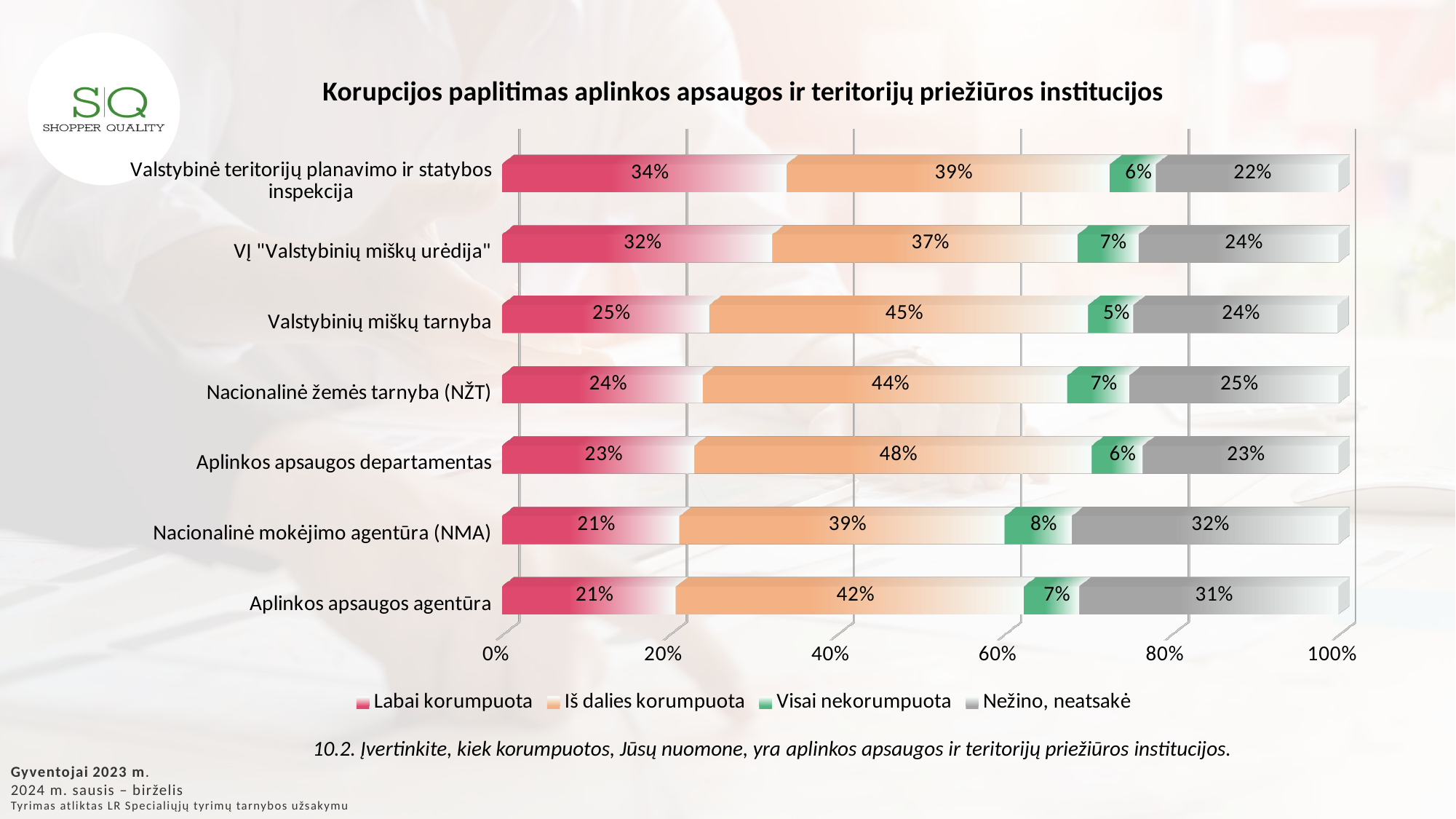
What is the total of the stacked bar for Nacionalinė žemės tarnyba (NŽT)? 100% How many series does the legend list? 4 What is the 'Nežino, neatsakė' value for Nacionalinė mokėjimo agentūra (NMA)? 32% How many institutions (categories) are shown in the chart? 7 What is the 'Labai korumpuota' value for Valstybinė teritorijų planavimo ir statybos inspekcija? 34% What kind of chart is shown on the slide? Stacked bar chart What is the title of the chart? Korupcijos paplitimas aplinkos apsaugos ir teritorijų priežiūros institucijos Which institution has the lowest 'Visai nekorumpuota' value? Valstybinių miškų tarnyba Which institution has the highest 'Labai korumpuota' value? Valstybinė teritorijų planavimo ir statybos inspekcija Which is larger: the 'Nežino, neatsakė' value for Aplinkos apsaugos agentūra or for Valstybinių miškų tarnyba? Aplinkos apsaugos agentūra What is the difference between the 'Iš dalies korumpuota' values for Aplinkos apsaugos departamentas and VĮ "Valstybinių miškų urėdija"? 11% What is the 'Iš dalies korumpuota' value for Aplinkos apsaugos departamentas? 48%